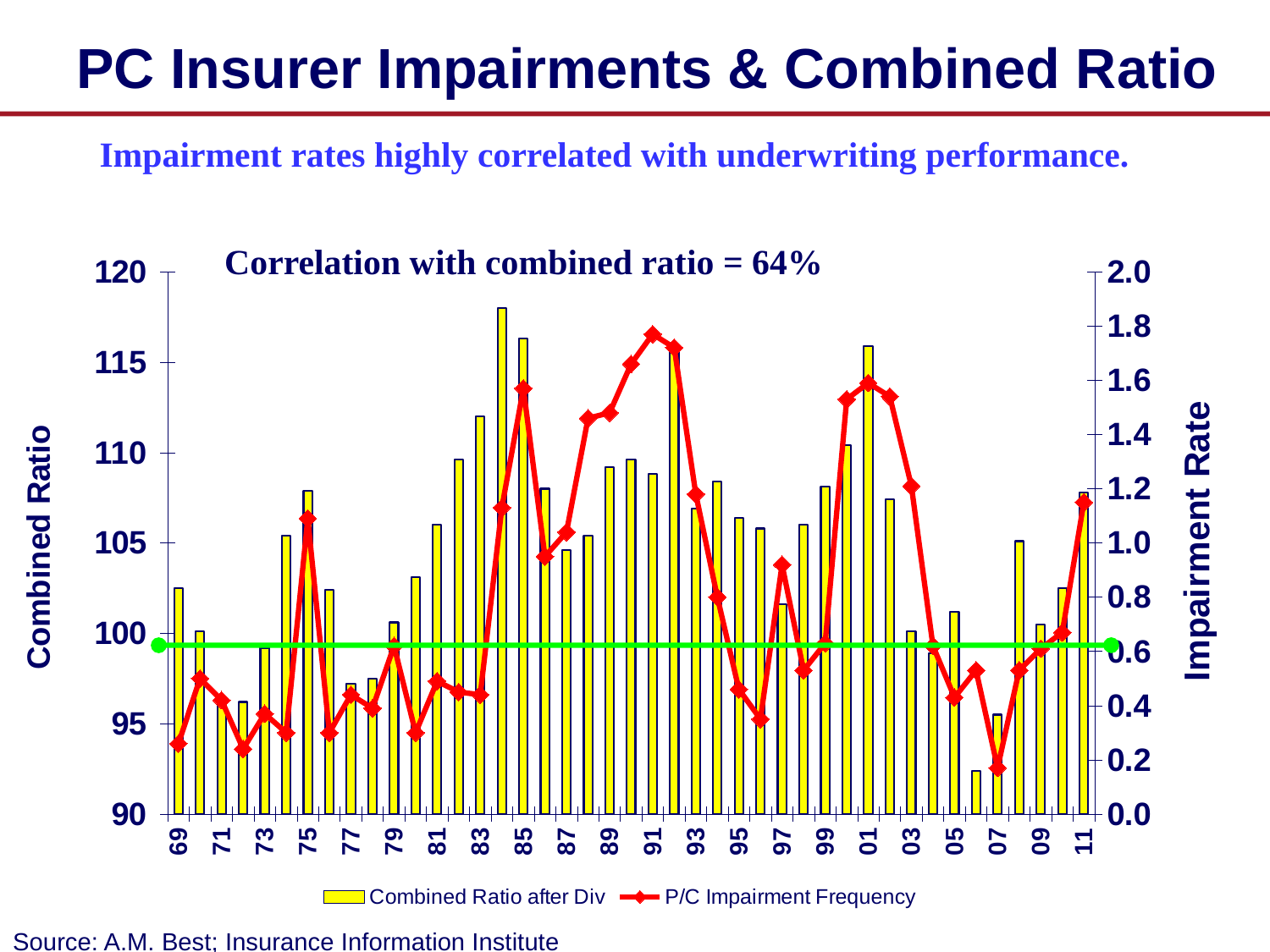
In which year is the Combined Ratio after Div bar the lowest? 06 What is the label on the right-hand vertical axis? Impairment Rate In which year is the Combined Ratio after Div bar the highest? 84 How many series does the legend list? 2 Is the P/C Impairment Frequency for 91 greater or less than 1.6? greater Is the Combined Ratio after Div for 06 greater or less than 95? less Which year has the larger P/C Impairment Frequency, 01 or 07? 01 What is the title printed inside the chart area? Correlation with combined ratio = 64% In which year is the P/C Impairment Frequency at its lowest? 07 Does the P/C Impairment Frequency rise or fall from 01 to 07? fall Is the Combined Ratio after Div for 84 greater or less than 115? greater What kind of chart is shown on the slide? A combination bar and line chart